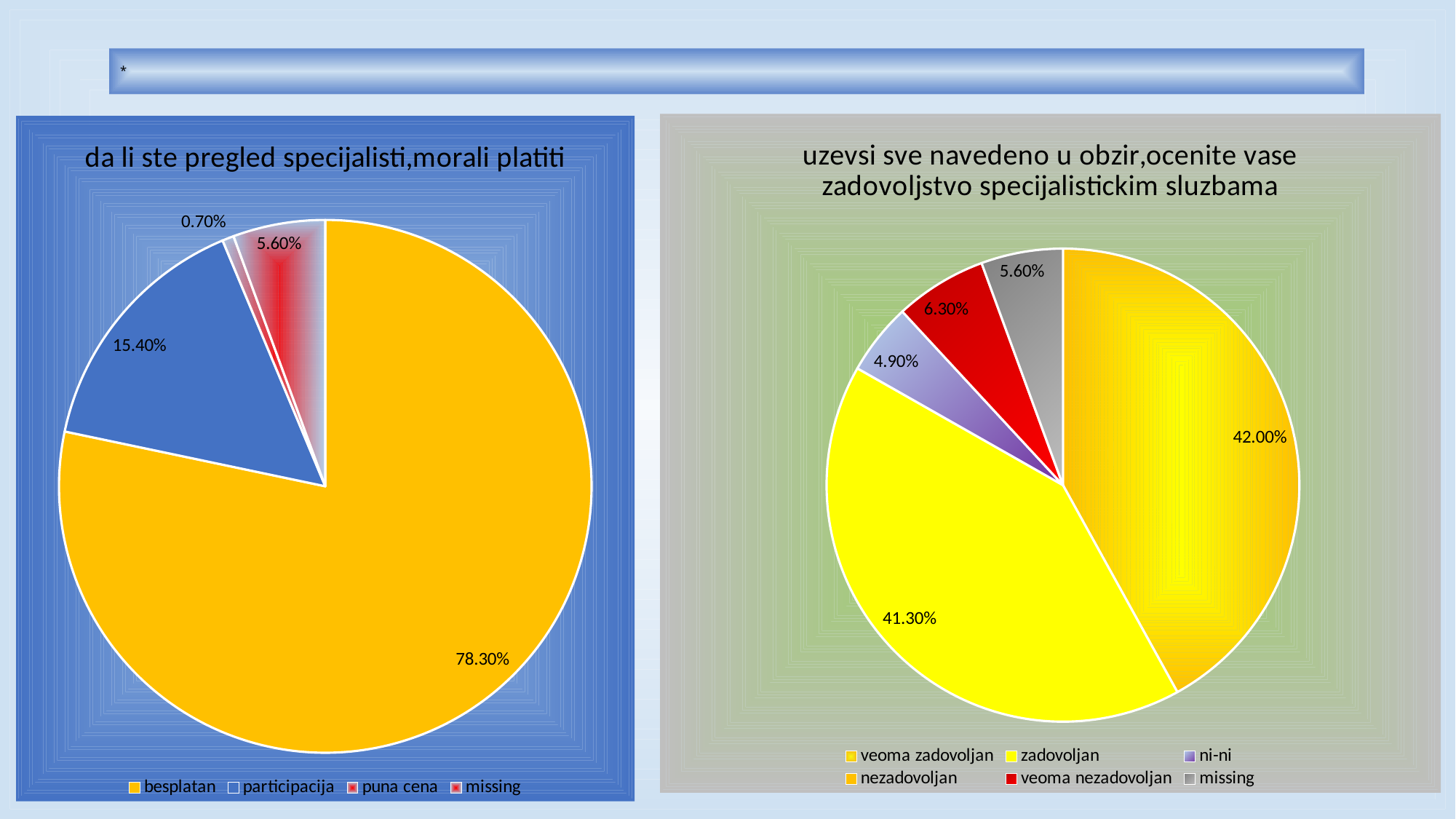
On the left chart, what percentage is shown for besplatan? 78.30% On the left chart, which category has the largest slice? besplatan On the right chart, what percentage is shown for zadovoljan? 41.30% How many categories does the legend of the right chart list? 6 How many categories does the legend of the left chart list? 4 On the right chart, what percentage is shown for veoma nezadovoljan? 6.30% What kind of chart is the left chart? pie chart On the right chart, which is larger: veoma nezadovoljan or ni-ni? veoma nezadovoljan On the left chart, what is the difference between the 78.30% slice and the 15.40% slice? 62.90% On the right chart, what percentage is shown for missing? 5.60% On the left chart, what is the smallest percentage shown on any slice? 0.70% On the right chart, what percentage is shown for ni-ni? 4.90%